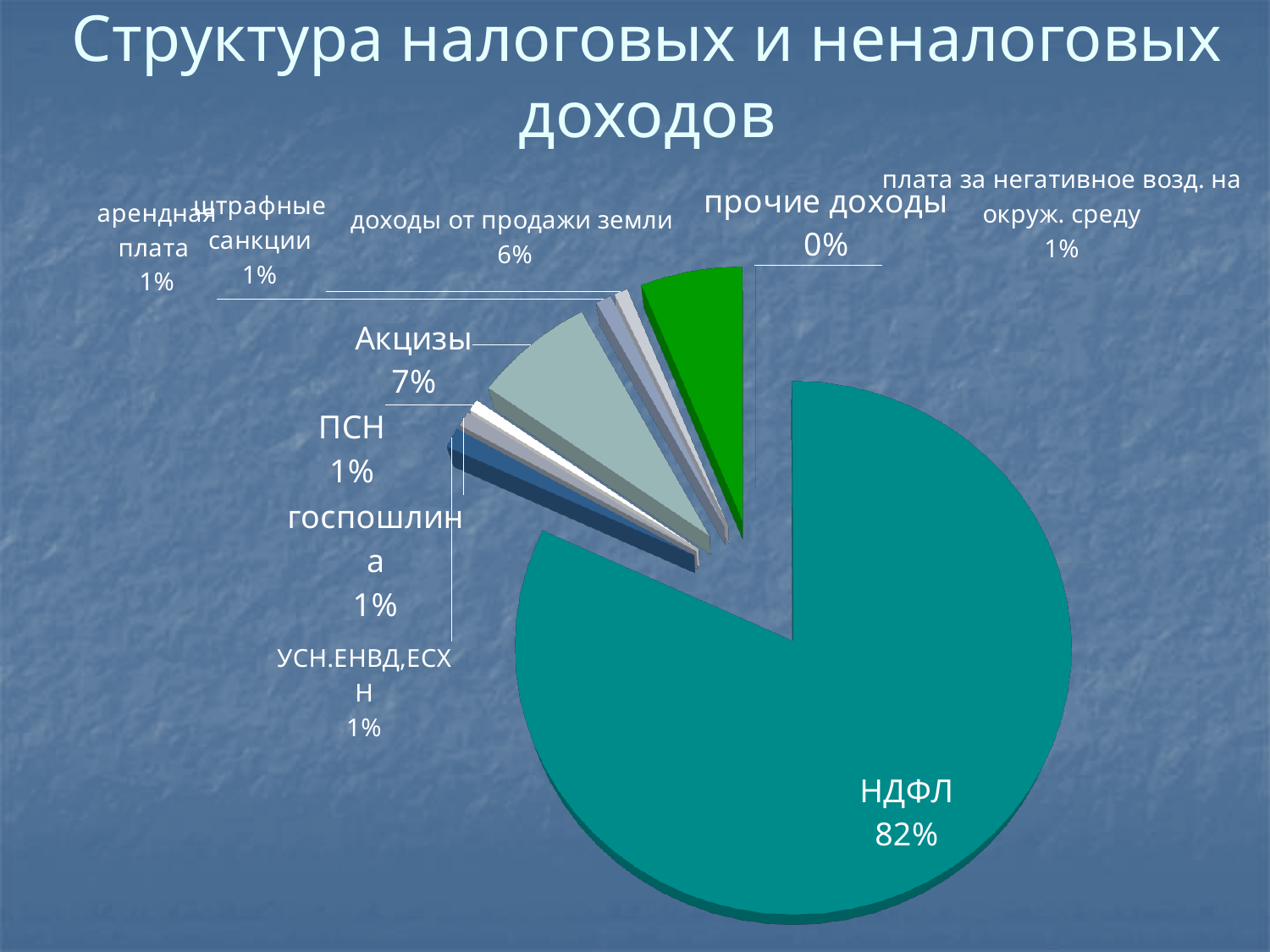
Which category has the largest share of the pie? НДФЛ What kind of chart is shown on the slide? pie chart What is the title of the chart? Структура налоговых и неналоговых доходов Which category has the smallest share of the pie? прочие доходы How many categories are shown in the pie chart? 10 Which has a larger share, Акцизы or доходы от продажи земли? Акцизы What share of the pie does НДФЛ have? 82% What share of the pie does Акцизы have? 7% What is the difference between the shares of НДФЛ and Акцизы? 75% What share of the pie does плата за негативное возд. на окруж. среду have? 1% What share of the pie does доходы от продажи земли have? 6% What share of the pie does прочие доходы have? 0%